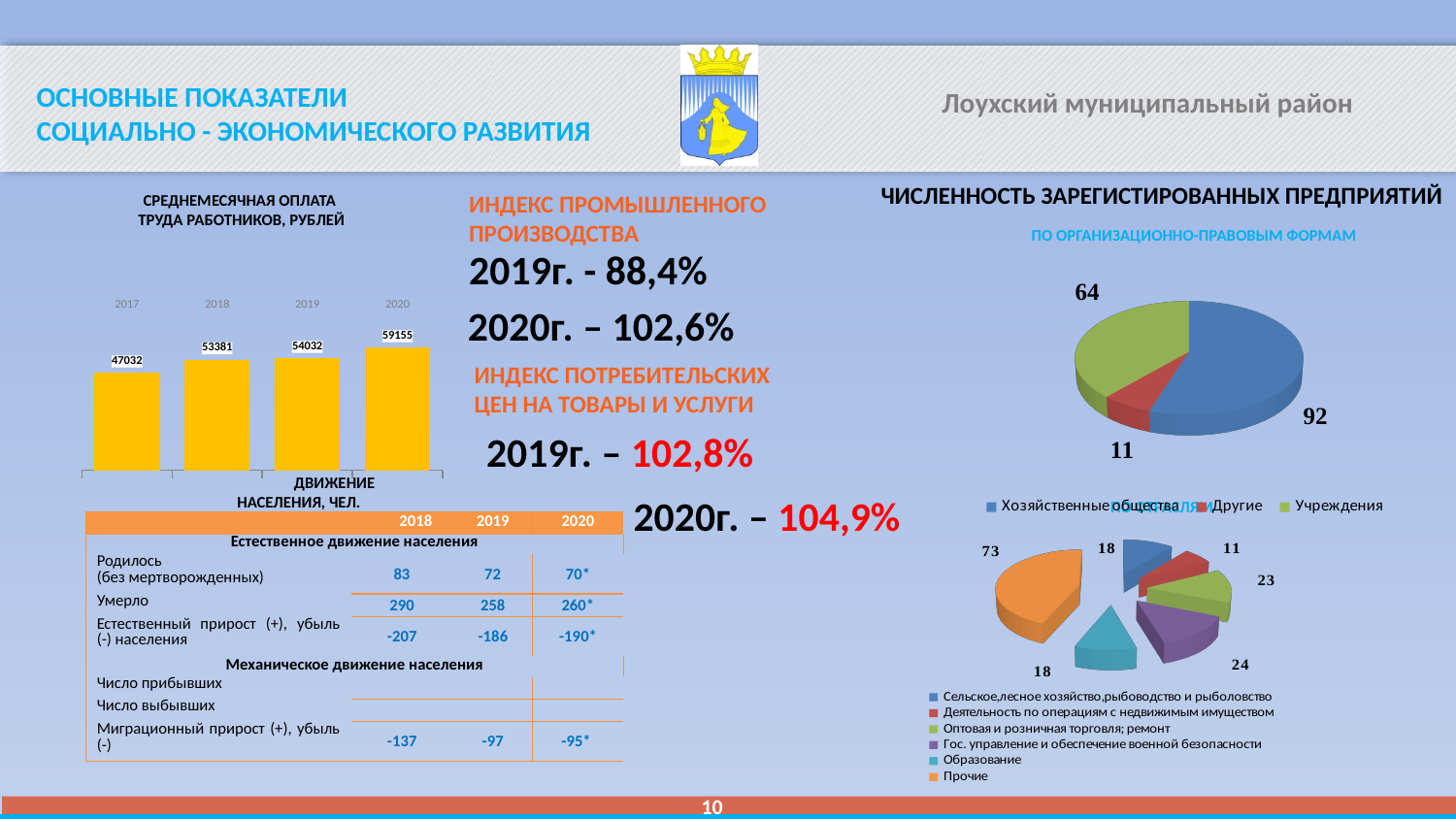
How many categories does the legend of the bottom-right pie chart list? 6 In the bar chart 'Среднемесячная оплата труда работников, рублей', what is the difference between the 2020 and 2017 values? 12123 In the bottom-right pie chart, which is larger: Оптовая и розничная торговля; ремонт or Гос. управление и обеспечение военной безопасности? Гос. управление и обеспечение военной безопасности In the top-right pie chart 'Численность зарегистрированных предприятий по организационно-правовым формам', what is the value for Хозяйственные общества? 92 In the bar chart 'Среднемесячная оплата труда работников, рублей', what is the value for 2020? 59155 In the bar chart 'Среднемесячная оплата труда работников, рублей', what is the value for 2017? 47032 In the bar chart 'Среднемесячная оплата труда работников, рублей', do the values rise or fall from 2017 to 2020? rise How many years are shown in the bar chart 'Среднемесячная оплата труда работников, рублей'? 4 In the top-right pie chart 'Численность зарегистрированных предприятий по организационно-правовым формам', which category has the smallest value? Другие In the bottom-right pie chart, what is the value for Прочие? 73 In the bar chart 'Среднемесячная оплата труда работников, рублей', which year has the highest value? 2020 In the bar chart 'Среднемесячная оплата труда работников, рублей', which year has the lowest value? 2017